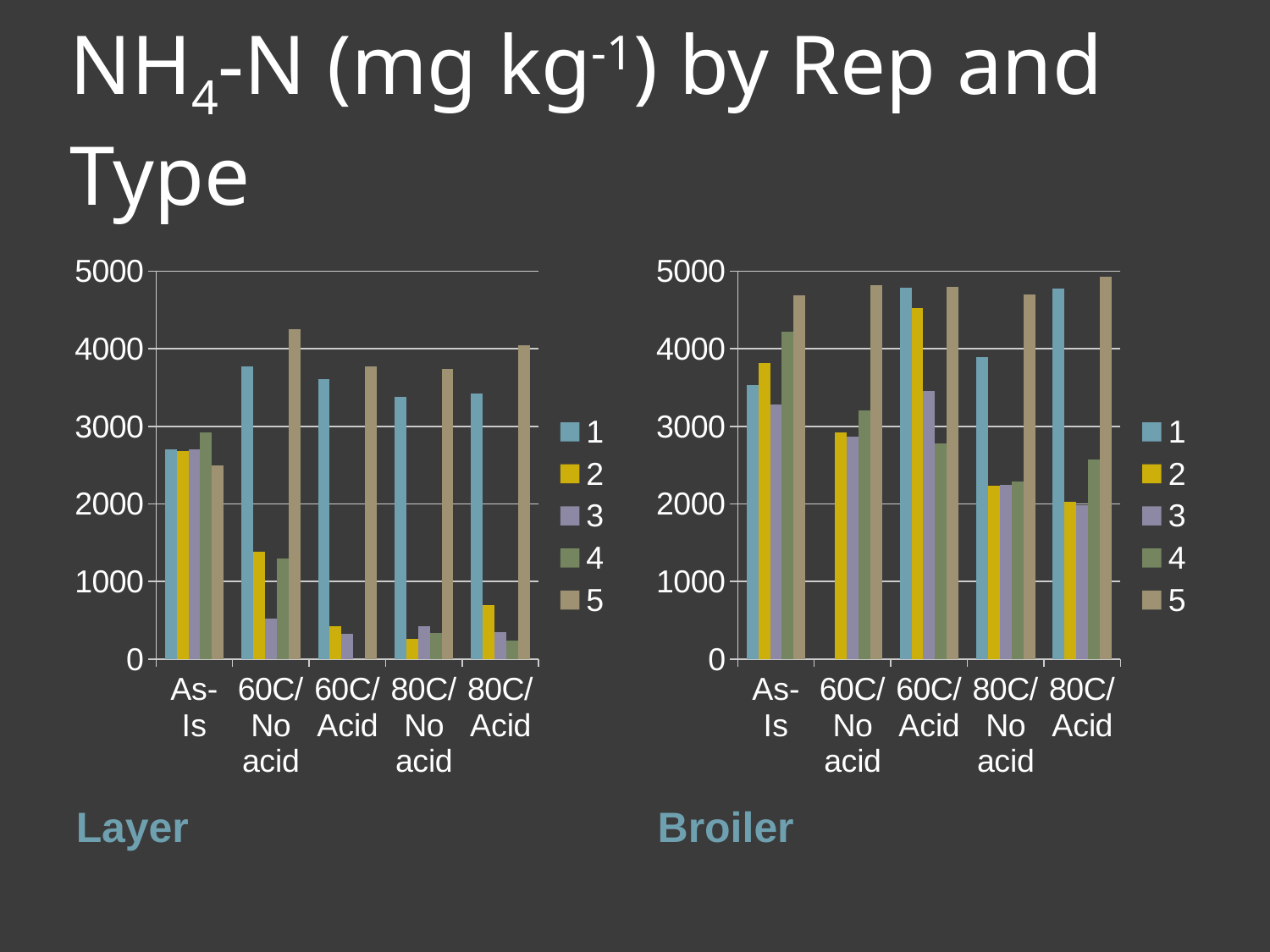
How many categories are shown on the x axis of the Layer chart? 5 What label appears below the right-hand chart? Broiler In the Layer chart, is the value for series 1 at 80C/No acid greater or less than 3000? greater In the Broiler chart, at As-Is, which is larger: series 1 or series 5? series 5 In the Broiler chart, is the value for series 5 at 80C/Acid greater or less than 4000? greater What kind of chart is the Layer chart on the left? bar chart In the Layer chart, at 60C/No acid, which is larger: series 1 or series 2? series 1 In the Layer chart, is the value for series 5 at 60C/No acid greater or less than 4000? greater How many series does the legend of the Broiler chart list? 5 In the Broiler chart, which series has the lowest value at 60C/Acid? 4